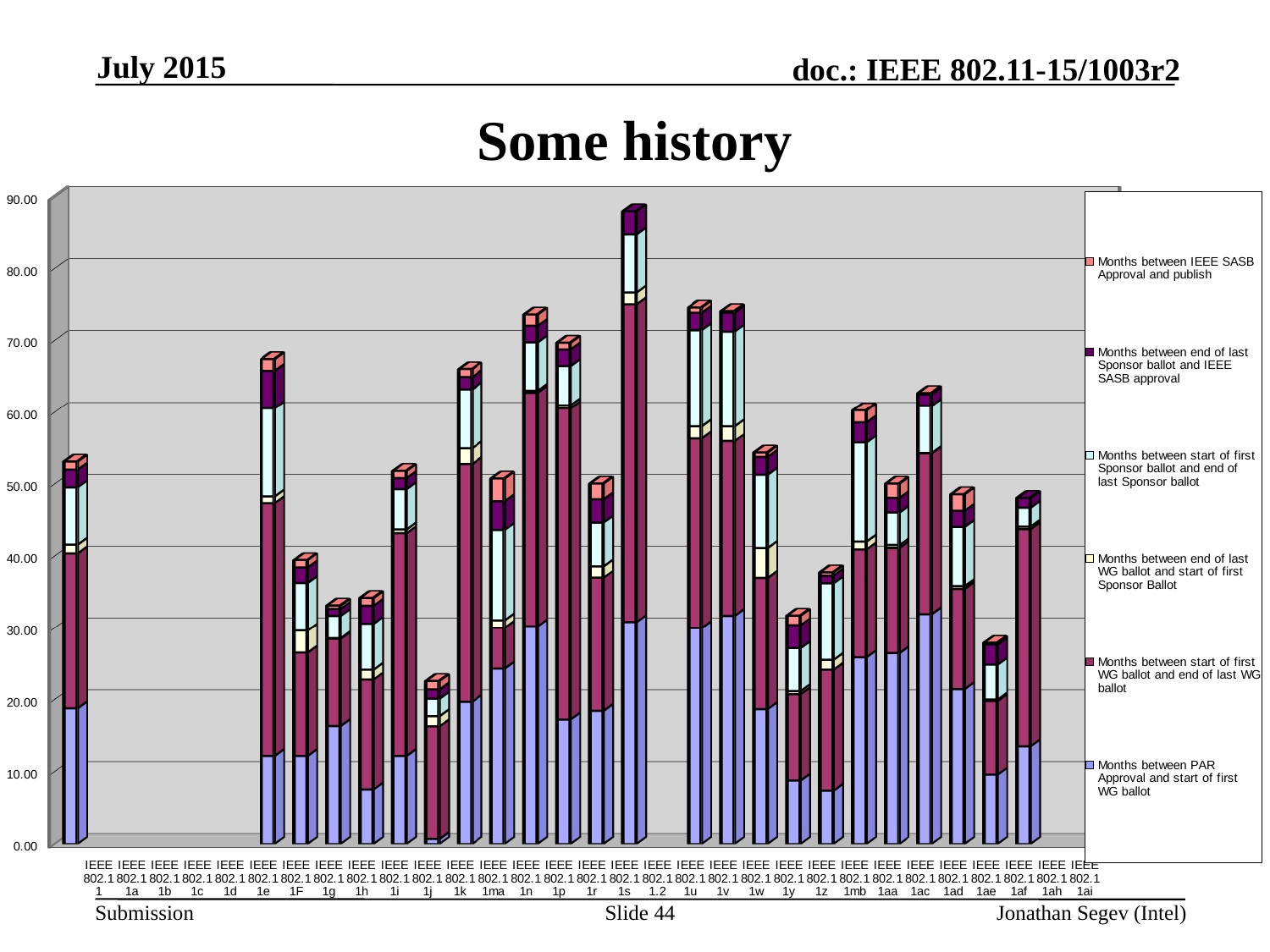
Is the total for IEEE 802.11s greater or less than 80? greater Which series is shown at the bottom of each stacked bar according to the legend? Months between PAR Approval and start of first WG ballot Which has the taller stacked bar, IEEE 802.11n or IEEE 802.11y? IEEE 802.11n Which category has the tallest stacked bar? IEEE 802.11s What kind of chart is shown on the slide? stacked bar chart Is the total for IEEE 802.11ae greater or less than 30? less How many series does the legend list? 6 What is the title of the chart? Some history How many categories are shown along the x axis? 31 Is the total for IEEE 802.11j greater or less than 30? less Which has the taller stacked bar, IEEE 802.11e or IEEE 802.11g? IEEE 802.11e